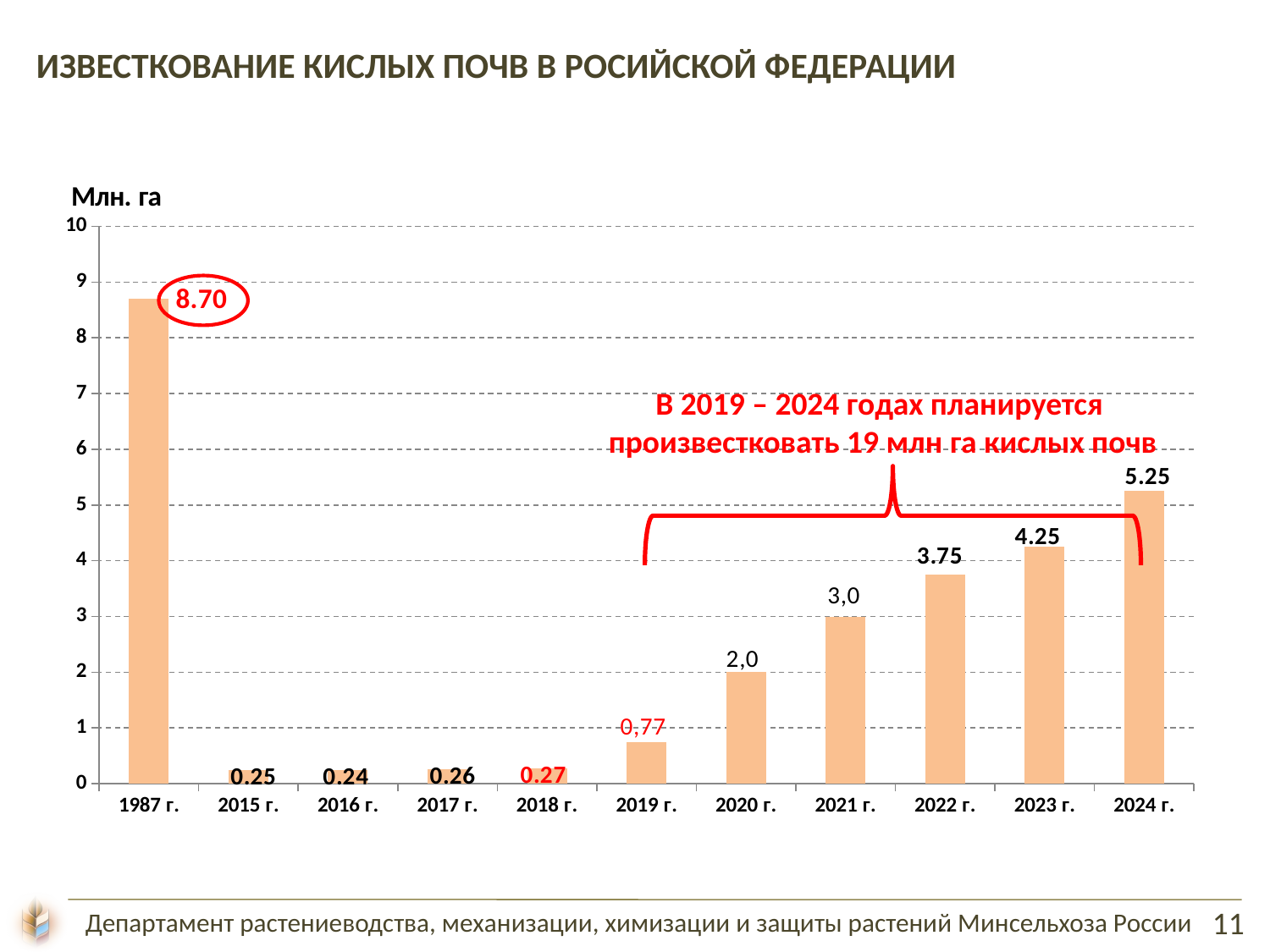
What type of chart is shown on the slide? bar chart Which year has the highest value? 1987 г. What is the difference between the values for 1987 г. and 2024 г.? 3.45 Which year has the lowest value? 2016 г. How many years are shown on the x axis? 11 Do the values rise or fall from 2019 г. to 2024 г.? rise What is the value for 2024 г.? 5.25 What is the value for 1987 г.? 8.70 What is the difference between the values for 2024 г. and 2022 г.? 1.50 What is the value for 2019 г.? 0,77 What is the value for 2022 г.? 3.75 Which is larger, the value for 2023 г. or the value for 2021 г.? 2023 г.